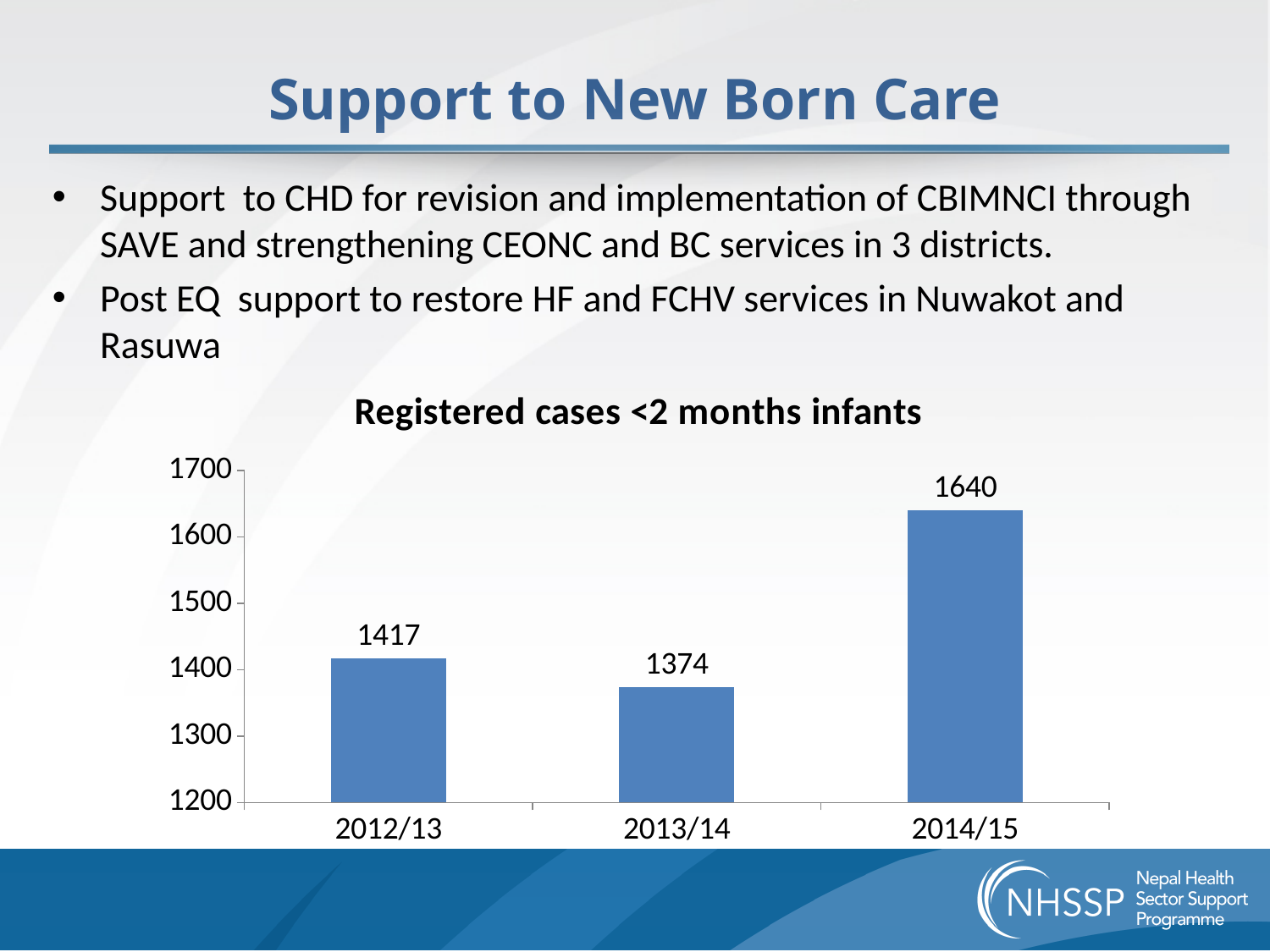
What is the value for 2014/15 in the chart? 1640 Which year has the highest number of registered cases? 2014/15 Which year has the lowest number of registered cases? 2013/14 What is the value for 2013/14 in the chart? 1374 Which is larger, the value for 2012/13 or the value for 2014/15? 2014/15 What is the value for 2012/13 in the chart? 1417 How many years are shown on the x axis of the chart? 3 What is the difference between the values for 2014/15 and 2013/14? 266 What kind of chart is shown on the slide? bar chart What is the title of the chart? Registered cases <2 months infants Is the value for 2014/15 greater or less than 1600? greater What is the difference between the values for 2012/13 and 2013/14? 43